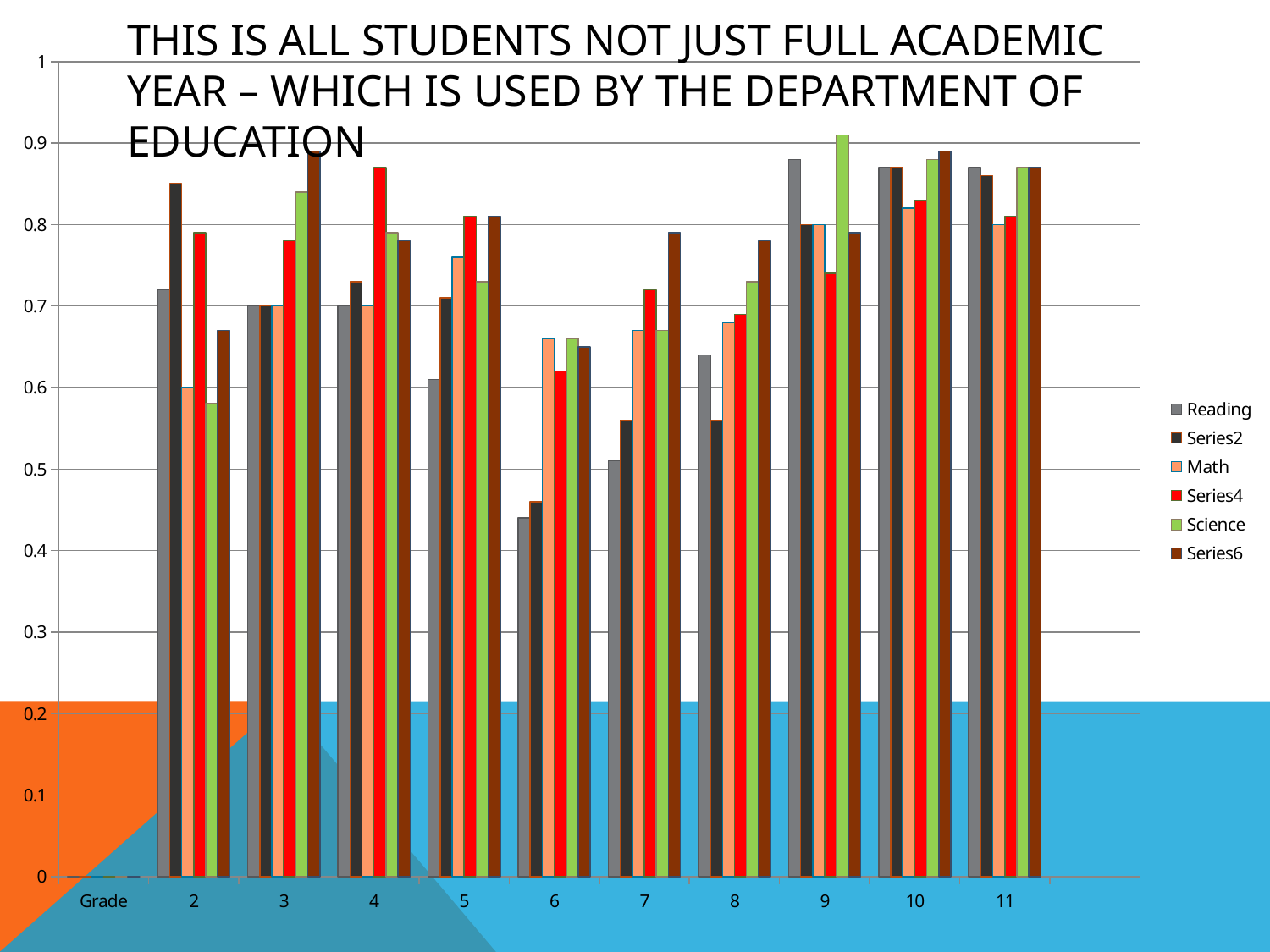
Is the Series6 value for grade 3 greater or less than 0.8? greater What kind of chart is shown on the slide? bar chart Is the Series4 value for grade 4 greater or less than 0.8? greater Is the Reading value for grade 6 greater or less than 0.5? less Which series is shown in red in the legend? Series4 At grade 2, which is larger: the Series6 value or the Math value? Series6 How many series does the legend list? 6 Which series is shown in green in the legend? Science Which series has the lowest value at grade 6? Reading At grade 9, which is larger: the Science value or the Reading value? Science